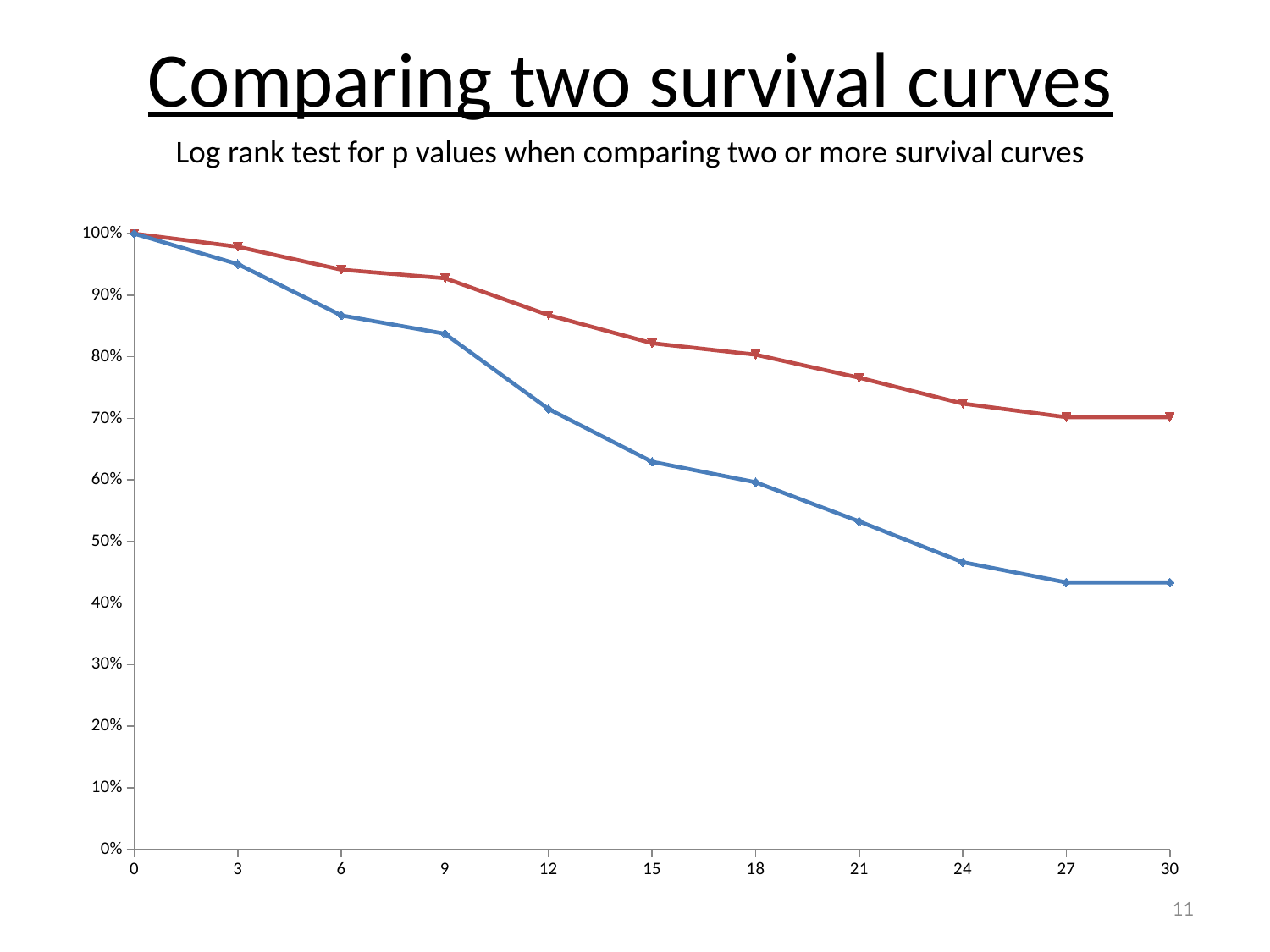
Is the value of the blue line at x = 15 greater or less than 60%? greater What is the title of the slide containing the chart? Comparing two survival curves What is the value of both curves at x = 0? 100% Is the value of the red line at x = 12 greater or less than 80%? greater Which line is higher at x = 30, the red line or the blue line? red line How many data points does each line have? 11 What kind of chart is shown on the slide? line chart Is the value of the red line at x = 21 greater or less than 80%? less How many lines are plotted on the chart? 2 Do the survival curves rise or fall as x increases from 0 to 30? fall